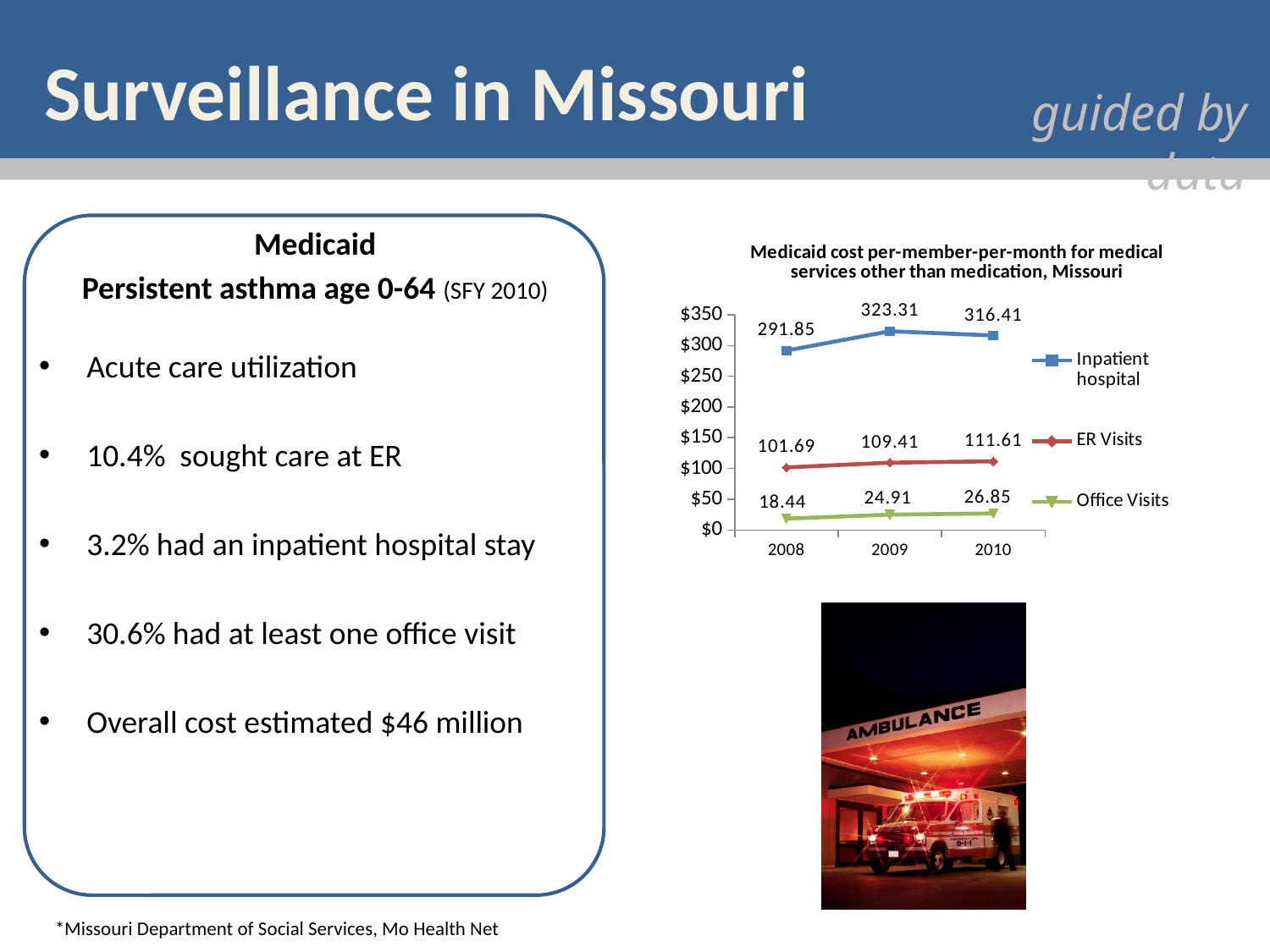
What is the Inpatient hospital cost per-member-per-month in 2009? 323.31 In which year was the Inpatient hospital cost highest? 2009 What is the ER Visits value for 2010? 111.61 Is the Inpatient hospital value for 2008 greater or less than $250? greater In which year was the ER Visits cost lowest? 2008 How many years are shown on the x axis of the chart? 3 Do the Office Visits values rise or fall from 2008 to 2010? Rise What kind of chart is shown on the slide? Line chart How many series does the chart legend list? 3 Which is larger in 2010: the ER Visits value or the Office Visits value? ER Visits What is the difference between the Inpatient hospital values for 2009 and 2008? 31.46 What is the Office Visits value for 2008? 18.44